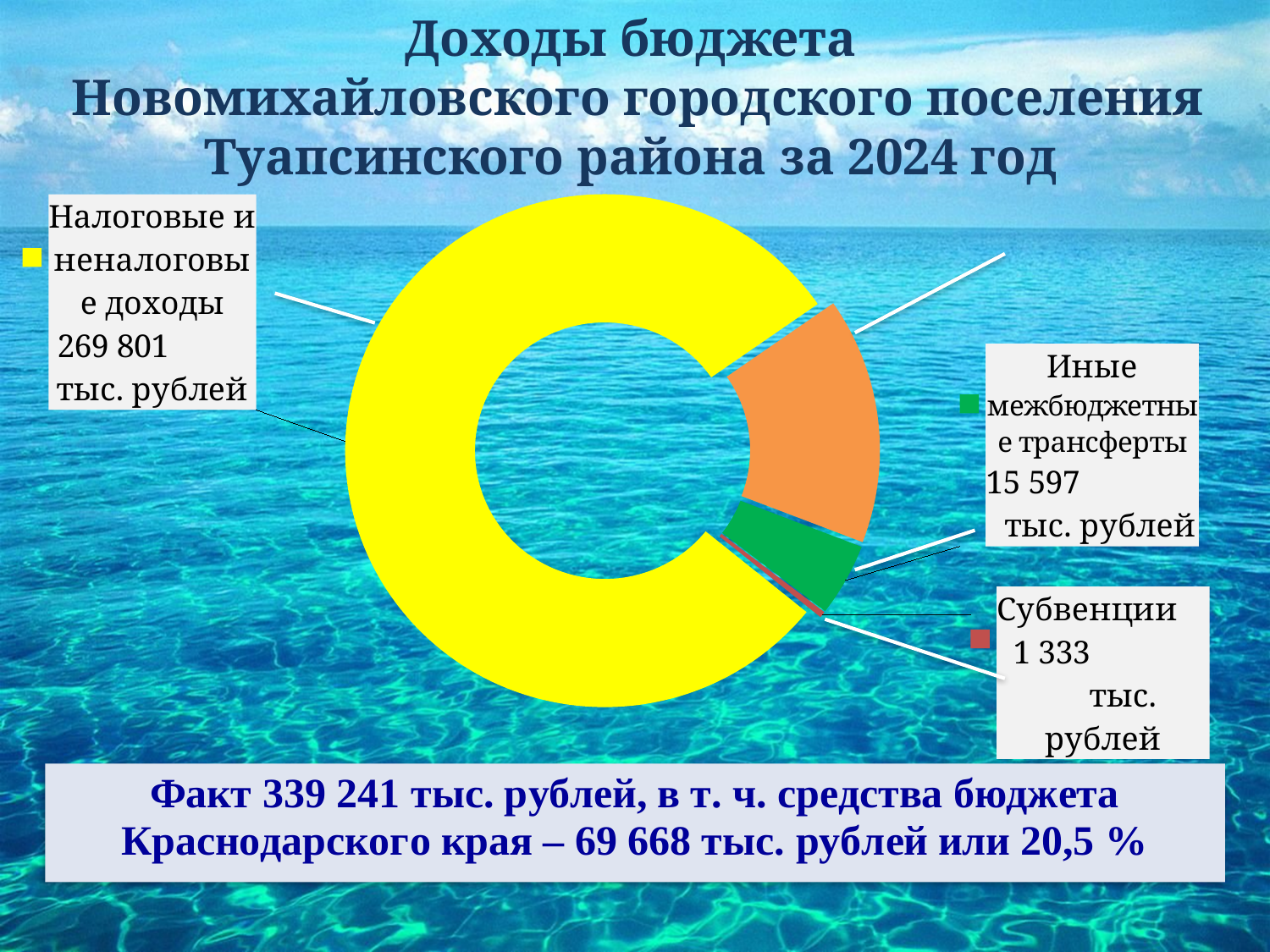
Which is larger: Налоговые и неналоговые доходы or Иные межбюджетные трансферты? Налоговые и неналоговые доходы What is the value shown for Иные межбюджетные трансферты? 15 597 тыс. рублей What colour is the segment for Налоговые и неналоговые доходы? Yellow Which labelled category has the largest segment in the chart? Налоговые и неналоговые доходы What is the value shown for Субвенции? 1 333 тыс. рублей What is the value shown for Налоговые и неналоговые доходы? 269 801 тыс. рублей What kind of chart is shown on the slide? Doughnut (pie) chart What colour is the segment for Субвенции? Red Which is larger: Иные межбюджетные трансферты or Субвенции? Иные межбюджетные трансферты What is the difference between Иные межбюджетные трансферты and Субвенции? 14 264 тыс. рублей What is the difference between Налоговые и неналоговые доходы and Иные межбюджетные трансферты? 254 204 тыс. рублей